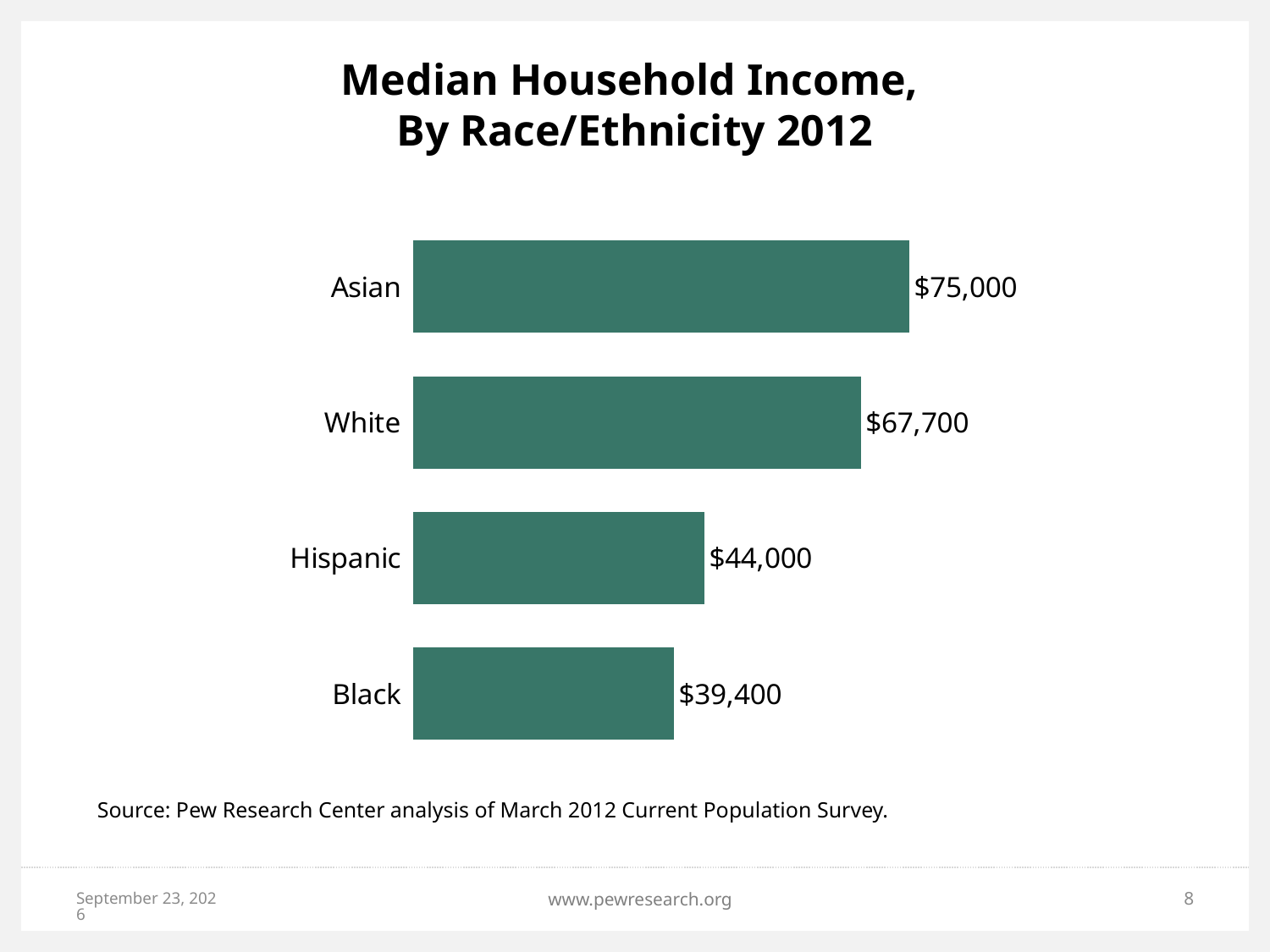
What is the difference between the median household income of Hispanic and Black households? $4,600 What is the median household income for Black households? $39,400 What is the difference between the median household income of Asian and White households? $7,300 What is the median household income for Hispanic households? $44,000 Which race/ethnicity group has the highest median household income? Asian Which race/ethnicity group has the lowest median household income? Black Which group has a higher median household income, White or Hispanic? White What type of chart is shown on the slide? Bar chart What is the title of the chart? Median Household Income, By Race/Ethnicity 2012 What is the median household income for White households? $67,700 How many race/ethnicity groups are shown in the chart? 4 What is the median household income for Asian households? $75,000